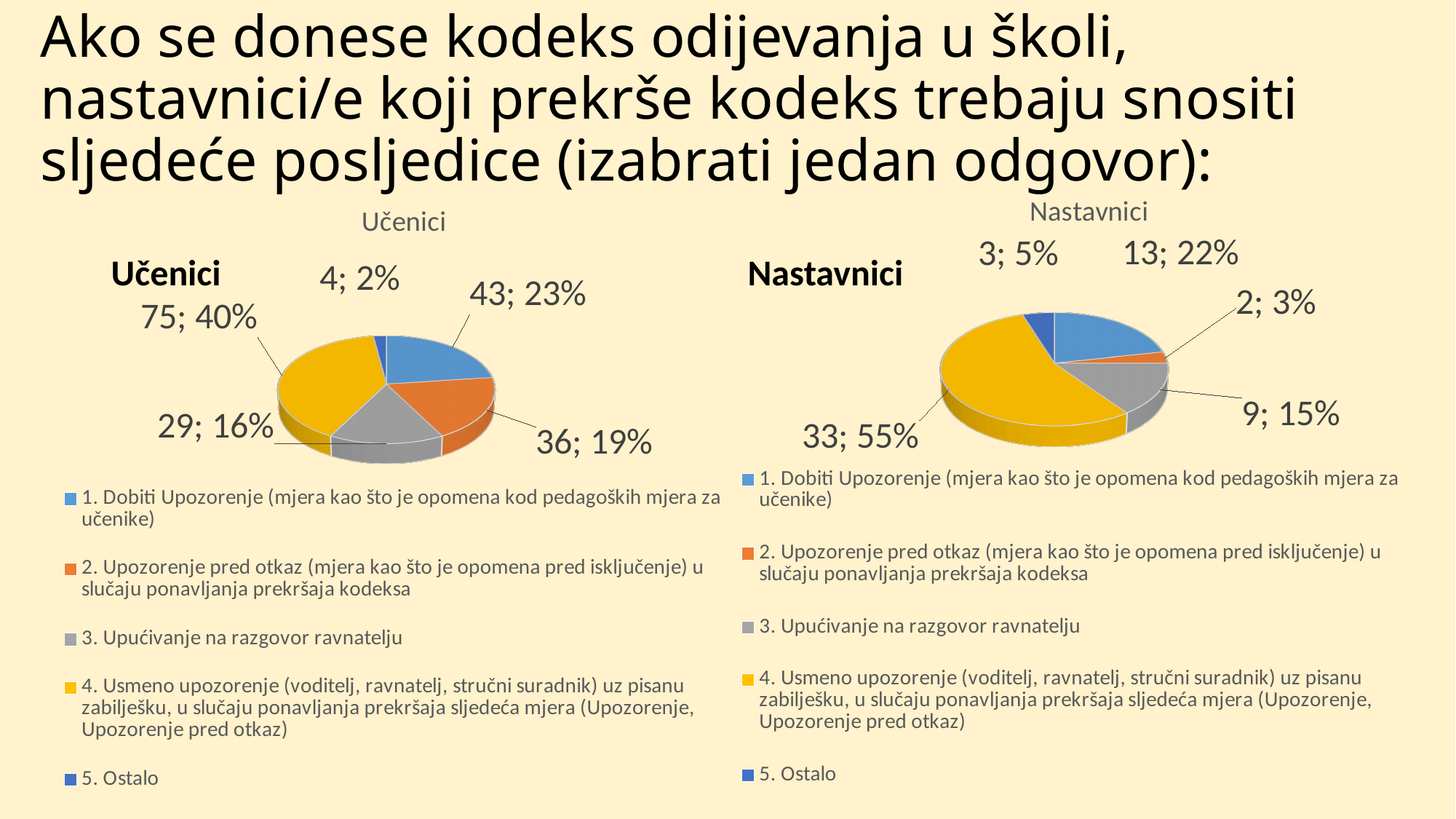
In the Učenici chart, which category has the smallest slice? 5. Ostalo What type of chart is the Nastavnici chart? Pie chart In the Učenici chart, what share of the pie does '2. Upozorenje pred otkaz' take? 19% In the Učenici chart, what is the difference in count between '1. Dobiti Upozorenje' and '2. Upozorenje pred otkaz'? 7 In the Nastavnici chart, what is the value for '1. Dobiti Upozorenje (mjera kao što je opomena kod pedagoških mjera za učenike)'? 13; 22% In the Nastavnici chart, what share of the pie does '5. Ostalo' take? 5% In the Nastavnici chart, which is larger: '3. Upućivanje na razgovor ravnatelju' or '5. Ostalo'? 3. Upućivanje na razgovor ravnatelju In the Učenici chart, what is the value for '4. Usmeno upozorenje (voditelj, ravnatelj, stručni suradnik) uz pisanu zabilješku...'? 75; 40% In the Nastavnici chart, which category has the largest slice? 4. Usmeno upozorenje (voditelj, ravnatelj, stručni suradnik) uz pisanu zabilješku, u slučaju ponavljanja prekršaja sljedeća mjera (Upozorenje, Upozorenje pred otkaz) In the Nastavnici chart, which category has the smallest slice? 2. Upozorenje pred otkaz (mjera kao što je opomena pred isključenje) u slučaju ponavljanja prekršaja kodeksa How many categories does the Učenici chart show? 5 In the Učenici chart, what is the value for '3. Upućivanje na razgovor ravnatelju'? 29; 16%